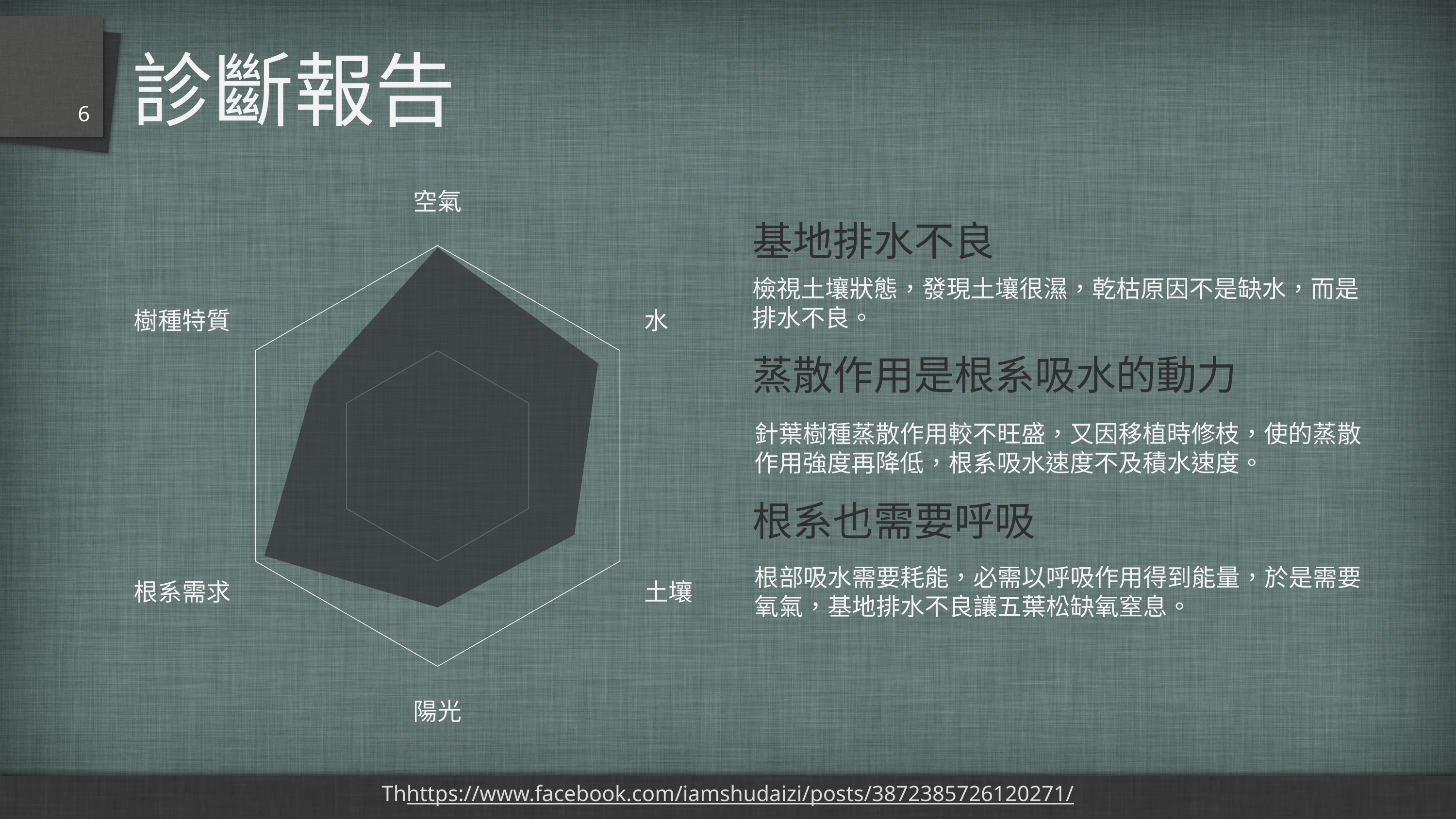
Which category label appears at the bottom of the radar chart? 陽光 Which is larger in the radar chart, the value for 根系需求 or the value for 土壤? 根系需求 Which is larger in the radar chart, the value for 空氣 or the value for 土壤? 空氣 How many categories (axes) does the radar chart have? 6 Which is larger in the radar chart, the value for 空氣 or the value for 陽光? 空氣 Which category label appears at the top of the radar chart? 空氣 What kind of chart is shown on the slide? Radar chart